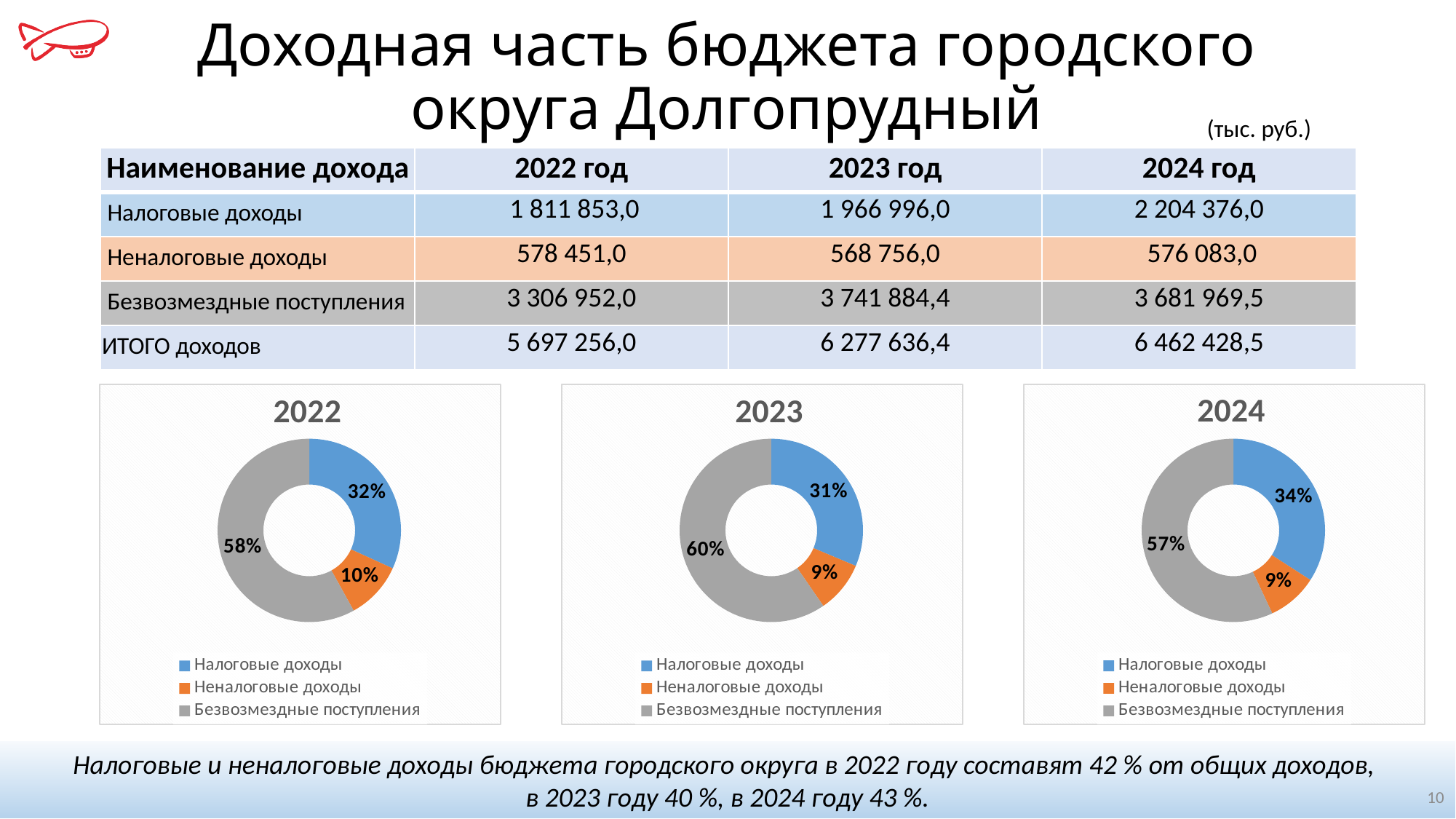
In the 2023 chart, what share is shown for Безвозмездные поступления? 60% In the 2022 chart, what share is shown for Налоговые доходы? 32% How many categories does the 2022 chart show? 3 In the 2024 chart, what share is shown for Неналоговые доходы? 9% What is the title of the leftmost chart? 2022 What kind of chart is the 2024 chart? Pie (donut) chart In the 2022 chart, which category has the largest share? Безвозмездные поступления How many entries does the legend of the 2023 chart list? 3 In the 2024 chart, which is larger: the share of Налоговые доходы or the share of Неналоговые доходы? Налоговые доходы In the 2023 chart, what is the difference in percentage points between Безвозмездные поступления and Налоговые доходы? 29 In the 2023 chart, what colour represents Неналоговые доходы? Orange In the 2024 chart, which category has the smallest share? Неналоговые доходы